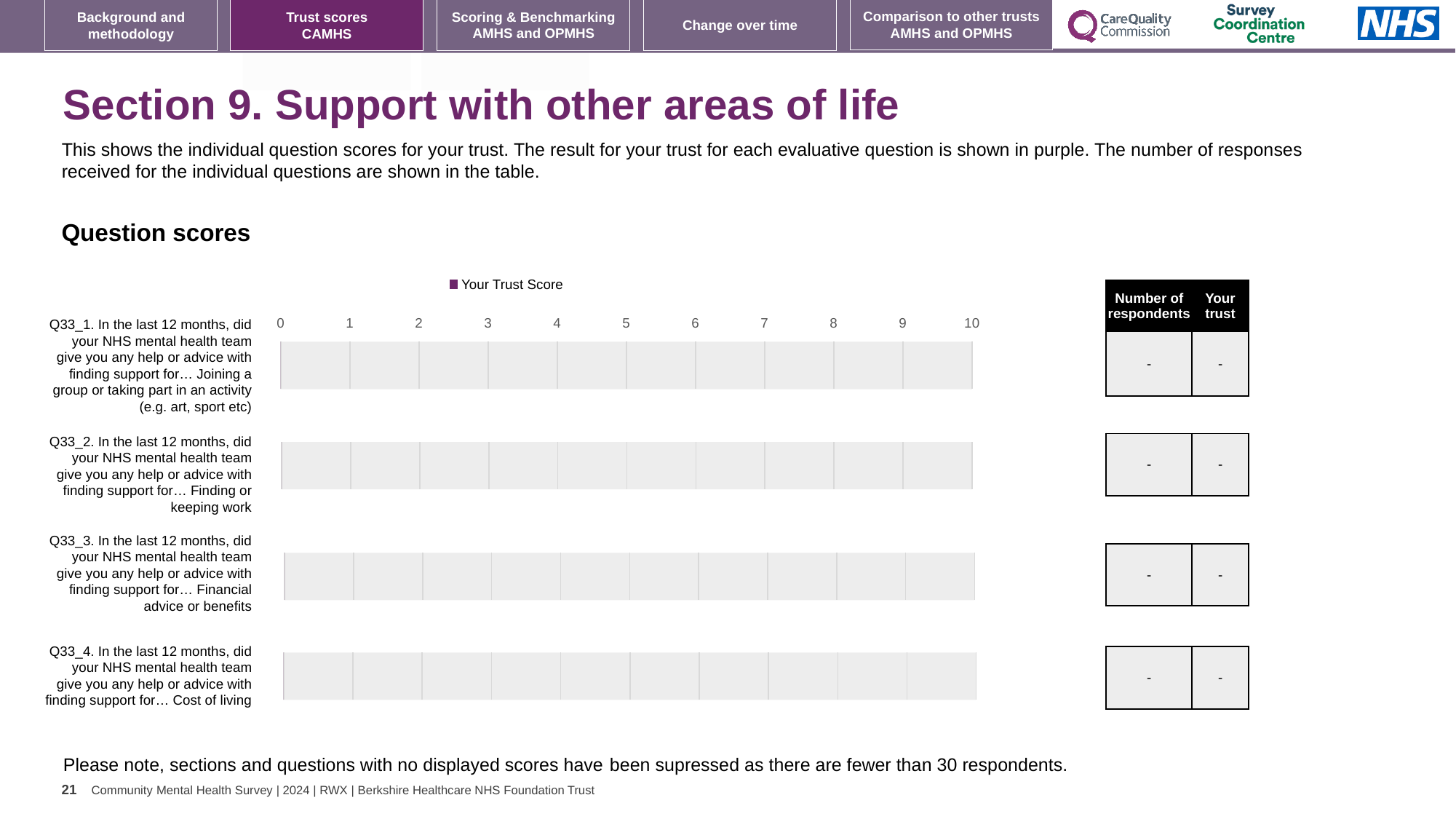
How many questions (categories) are listed on the 'Question scores' chart? 4 What is shown in the 'Number of respondents' column of the table for Q33_1 (Joining a group or taking part in an activity)? - What is the name of the series in the legend of the 'Question scores' chart? Your Trust Score What is the highest value shown on the x axis of the 'Question scores' chart? 10 Are any bars plotted for the questions on the 'Question scores' chart? No How many series does the legend of the 'Question scores' chart list? 1 What is shown in the 'Your trust' column of the table for Q33_4 (Cost of living)? - What kind of chart is shown under 'Question scores'? bar chart